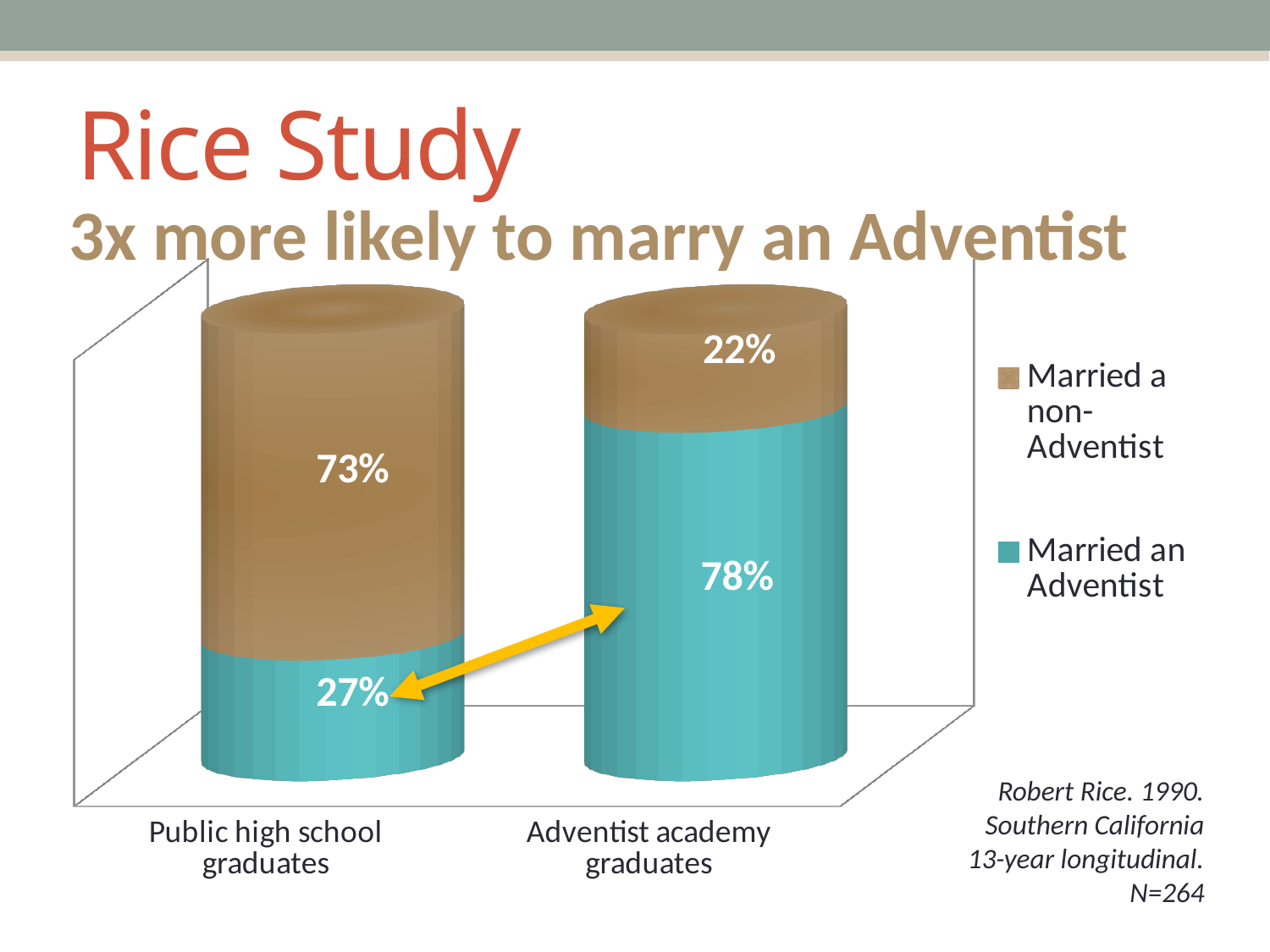
Is the 'Married a non-Adventist' value larger for public high school graduates or Adventist academy graduates? Public high school graduates What percentage of Adventist academy graduates married an Adventist? 78% What percentage of public high school graduates married a non-Adventist? 73% Which category has the higher value for 'Married an Adventist'? Adventist academy graduates Which category has the lower value for 'Married a non-Adventist'? Adventist academy graduates How many categories are shown on the x axis of the chart? 2 What are the two series named in the legend? Married a non-Adventist; Married an Adventist What is the difference between the 'Married an Adventist' values for Adventist academy graduates and public high school graduates? 51% What kind of chart is shown on the slide? Stacked bar chart What percentage of public high school graduates married an Adventist? 27% How many series does the legend list? 2 What percentage of Adventist academy graduates married a non-Adventist? 22%